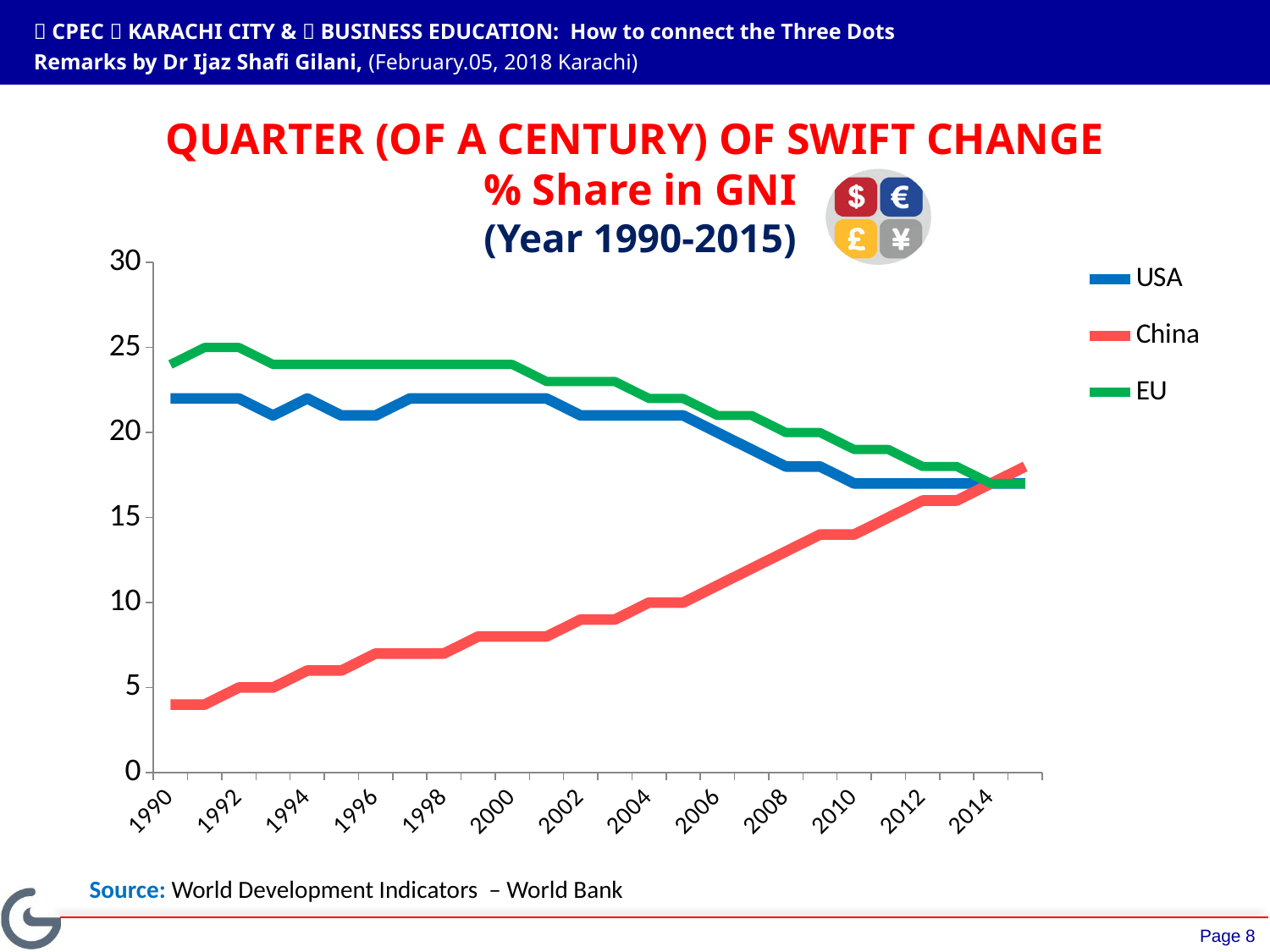
Which series are listed in the legend? USA, China, EU Does the value for EU rise or fall from 1990 to 2015? fall Is the value for China in 1990 greater or less than 5? less Does the value for China rise or fall from 1990 to 2015? rise Which series has the lowest value in 1990? China Which series has the highest value in 1990? EU What kind of chart is shown on the slide? line chart Is the value for USA in 2014 greater or less than 20? less Is the value for China in 2014 greater or less than 15? greater How many series does the legend list? 3 Does the value for USA rise or fall from 1990 to 2015? fall